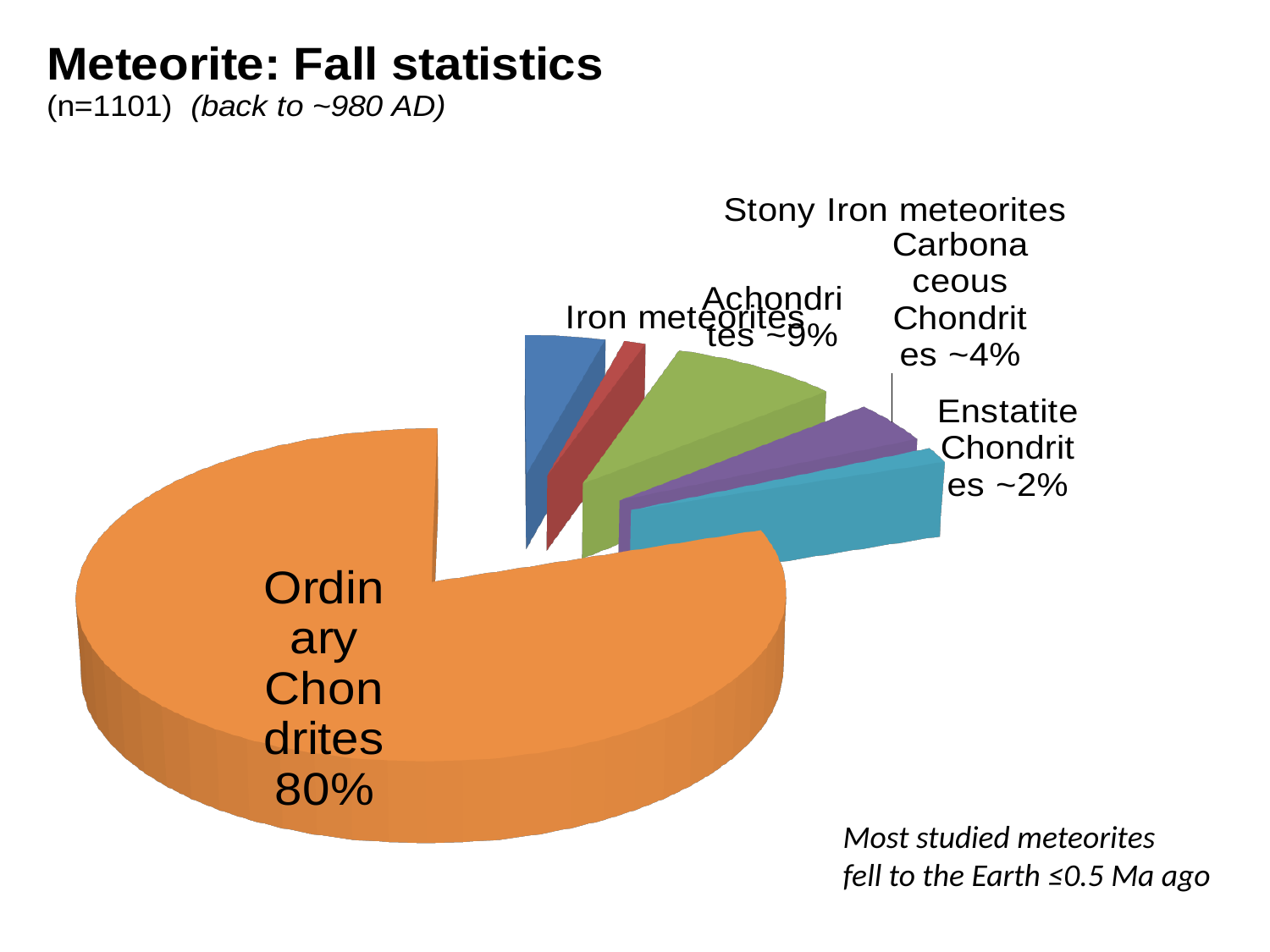
What value is printed for Carbonaceous Chondrites? ~4% What value is printed for Achondrites? ~9% How many slices does the pie chart have? 6 What sample size (n) is stated for the fall statistics? 1101 Which is larger, the slice for Achondrites or the slice for Enstatite Chondrites? Achondrites What kind of chart is shown on the slide? pie chart What value is printed for Enstatite Chondrites? ~2% Which is larger, the slice for Ordinary Chondrites or the slice for Carbonaceous Chondrites? Ordinary Chondrites Which category has the largest slice of the pie? Ordinary Chondrites What colour is the Ordinary Chondrites slice? orange What share of the pie do Ordinary Chondrites account for? 80% What is the title of the slide containing the pie chart? Meteorite: Fall statistics